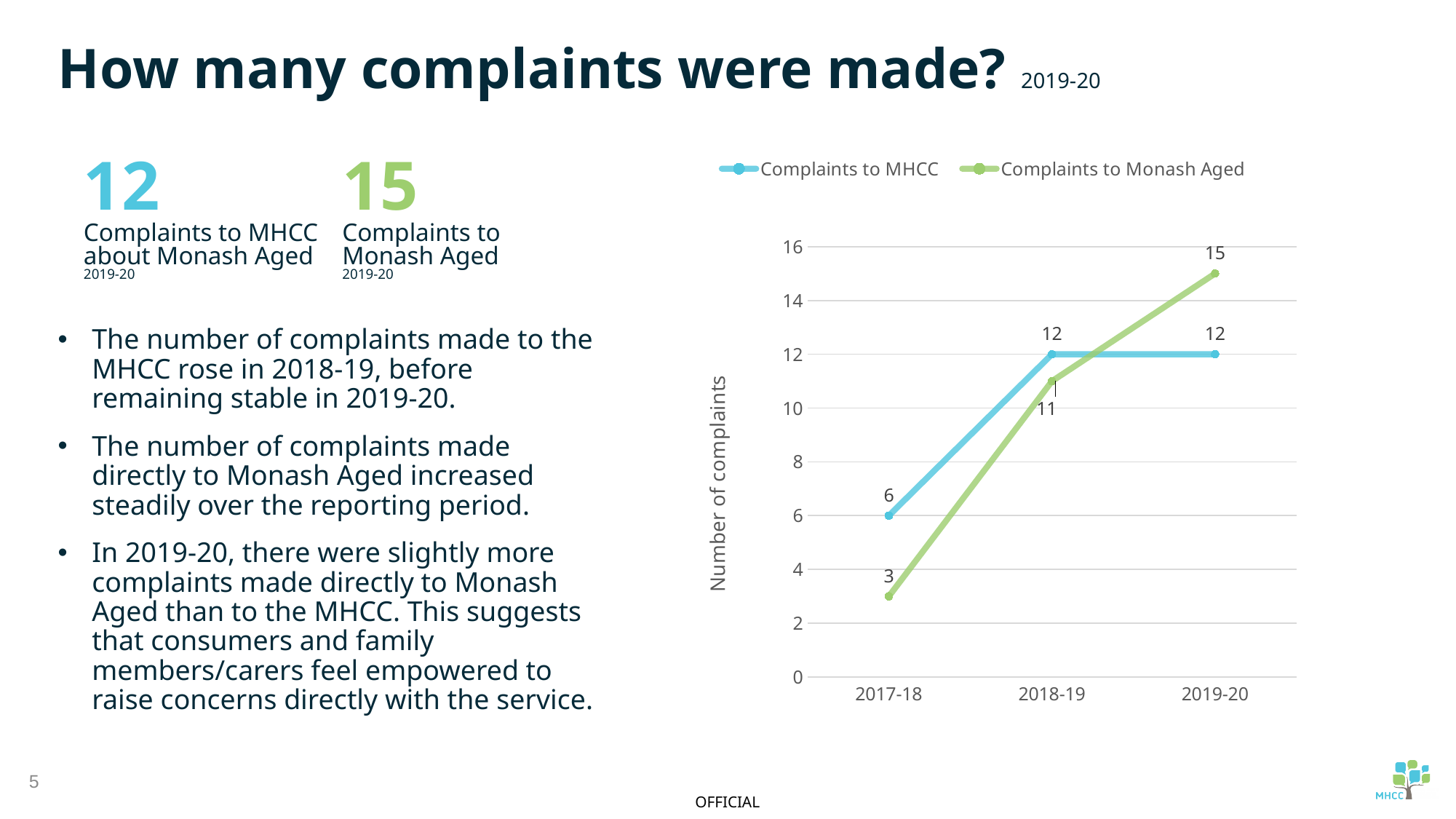
How many points are plotted along the x axis for each series? 3 What is the value for Complaints to Monash Aged in 2019-20? 15 In which year is the value for Complaints to Monash Aged lowest? 2017-18 What is the label on the vertical axis of the chart? Number of complaints What is the value for Complaints to Monash Aged in 2018-19? 11 What is the difference between Complaints to Monash Aged and Complaints to MHCC in 2019-20? 3 What type of chart is shown on the slide? line chart What is the value for Complaints to MHCC in 2017-18? 6 In which year is the value for Complaints to MHCC highest? 2018-19 and 2019-20 Which series has the larger value in 2017-18? Complaints to MHCC How many series does the legend list? 2 Do the values for Complaints to Monash Aged rise or fall from 2017-18 to 2019-20? rise